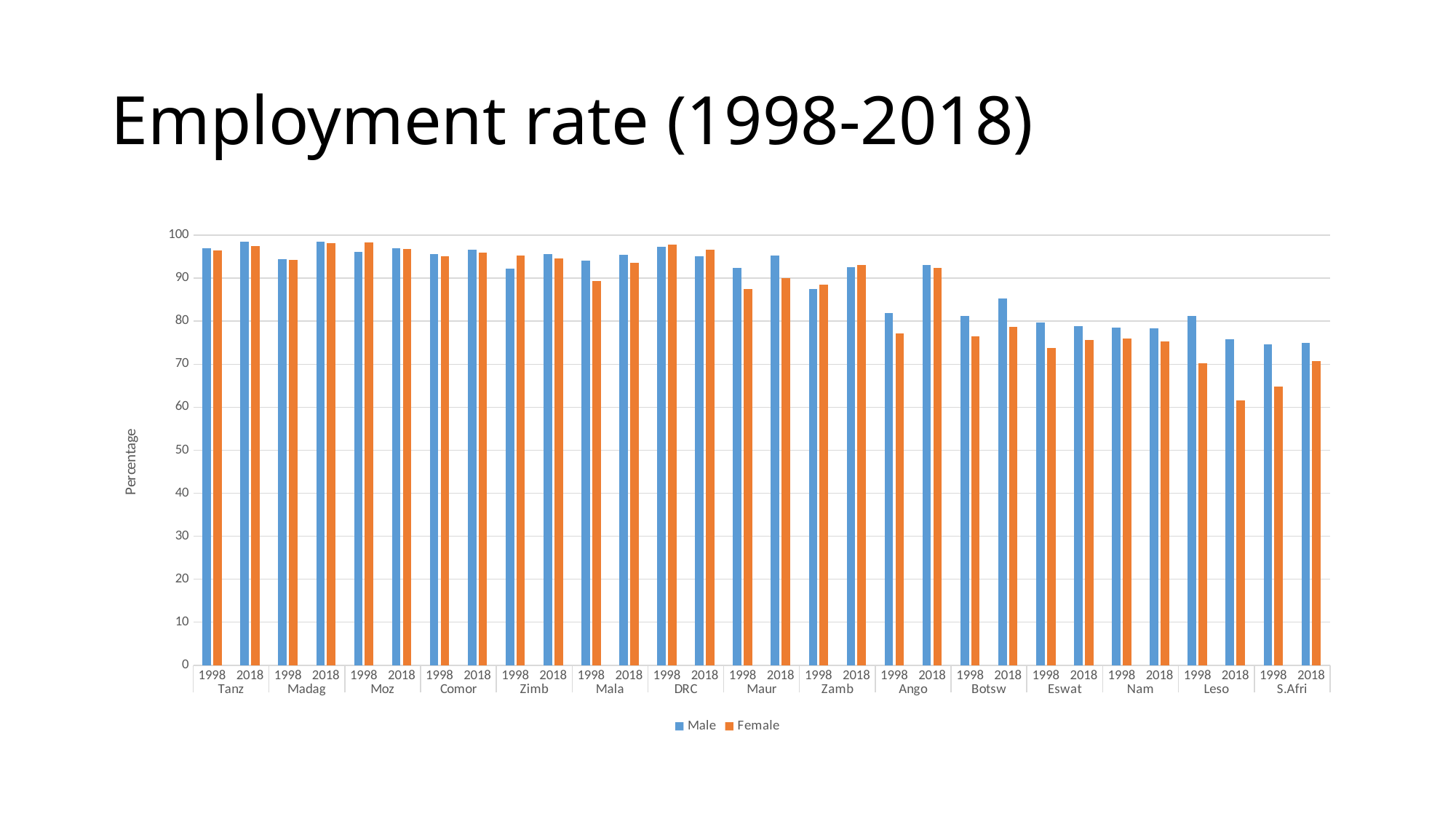
How many series does the legend list? 2 Is the Male value for Botsw in 2018 greater or less than 80? greater Is the Male value for Zamb in 1998 greater or less than 90? less How many countries are shown along the x axis? 15 What kind of chart is shown on the slide? bar chart What is the label on the vertical axis? Percentage Is the Female value for Leso in 2018 greater or less than 70? less What is the title of the chart? Employment rate (1998-2018) For Ango in 1998, which is larger, the Male or the Female value? Male Which country and year has the lowest Female value? Leso 2018 For Leso in 2018, which is larger, the Male or the Female value? Male